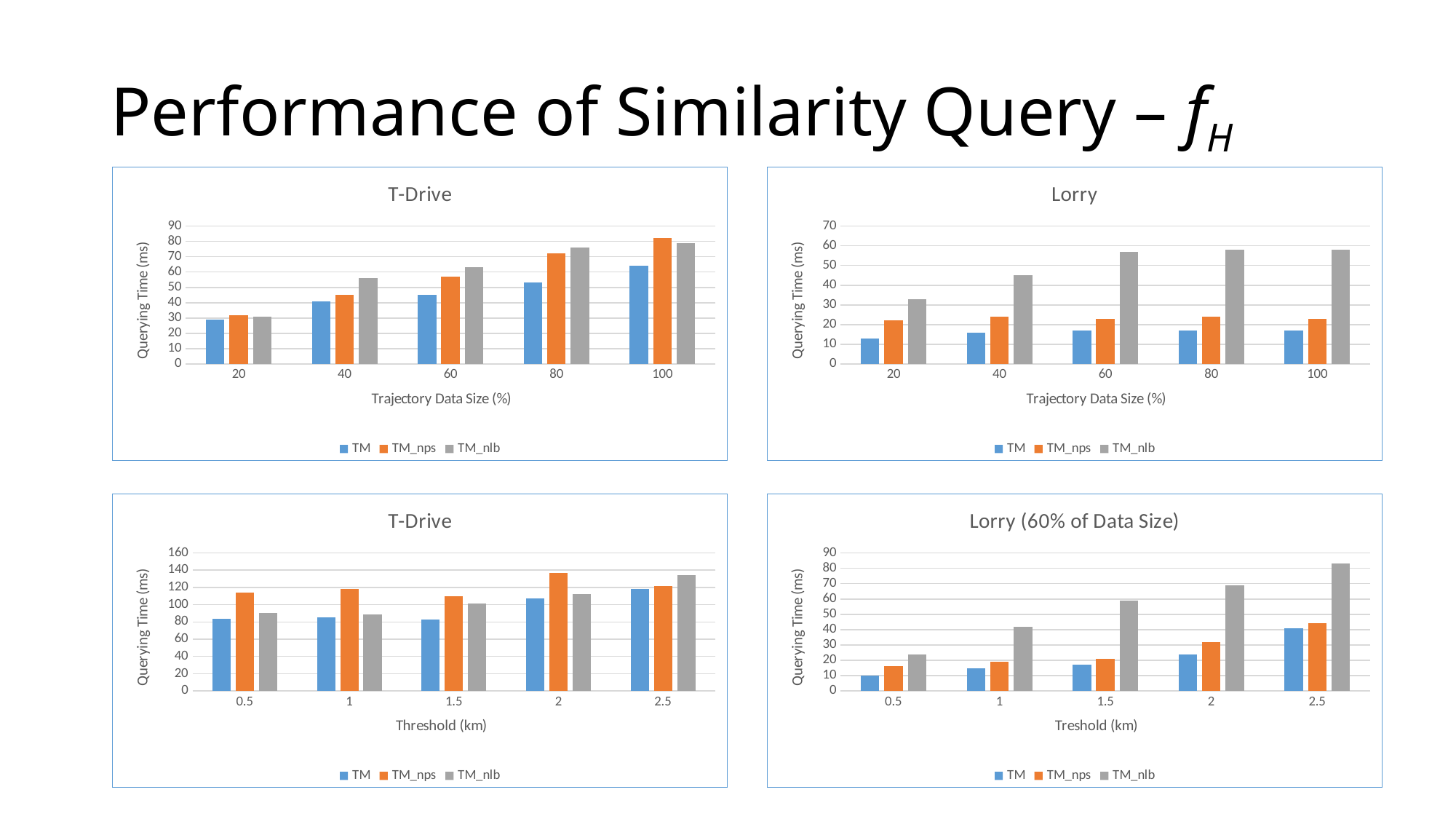
What kind of chart is the top-left T-Drive chart? bar chart In the top-right Lorry chart, at 20% data size, which is larger: TM_nps or TM_nlb? TM_nlb In the top-left T-Drive chart, at which trajectory data size is the TM_nps querying time highest? 100 In the bottom-right Lorry (60% of Data Size) chart, is the TM_nlb value at threshold 2.5 greater or less than 60? greater In the top-left T-Drive chart, do the TM values rise or fall as trajectory data size increases? rise In the bottom-left T-Drive chart, how many threshold categories are shown on the x axis? 5 In the top-right Lorry chart, how many series does the legend list? 3 What is the x-axis title of the bottom-left T-Drive chart? Threshold (km) In the bottom-left T-Drive chart, at which threshold is the TM_nps querying time highest? 2 In the top-right Lorry chart, is the TM value at 20% data size greater or less than 20? less In the bottom-right Lorry (60% of Data Size) chart, at which threshold is the TM querying time lowest? 0.5 In the top-left T-Drive chart, is the TM_nps value at 100% data size greater or less than 70? greater